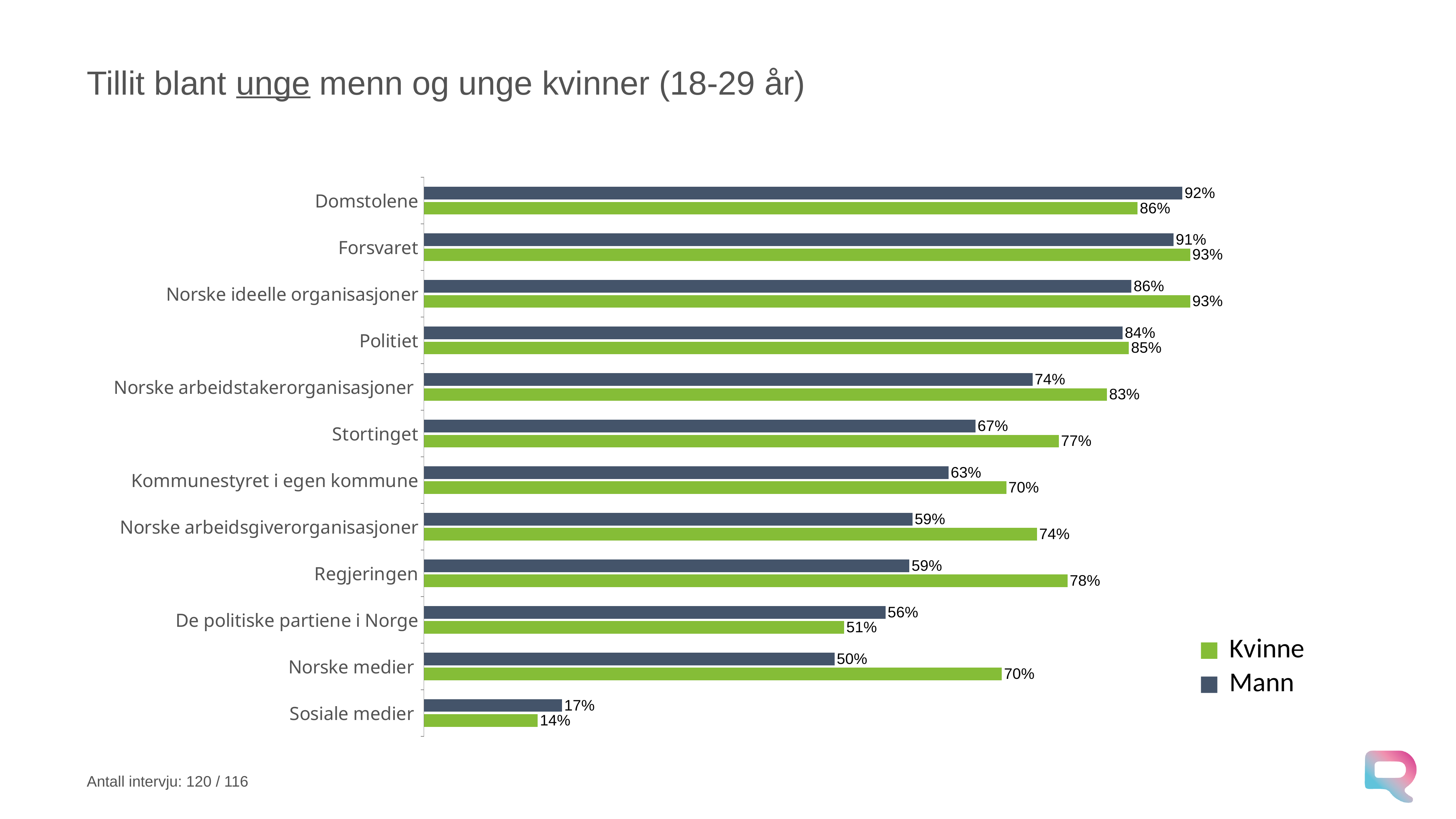
What is the Mann value for Stortinget? 67% For De politiske partiene i Norge, which is larger, the Kvinne value or the Mann value? Mann How many categories are shown on the chart? 12 What is the Mann value for Domstolene? 92% Which category has the lowest Kvinne value? Sosiale medier What is the Kvinne value for Regjeringen? 78% What kind of chart is shown on the slide? Bar chart What is the difference between the Kvinne and Mann values for Norske medier? 20% Which category has the highest Mann value? Domstolene What is the Kvinne value for Norske medier? 70% How many series does the legend list? 2 What is the difference between the Mann and Kvinne values for Domstolene? 6%